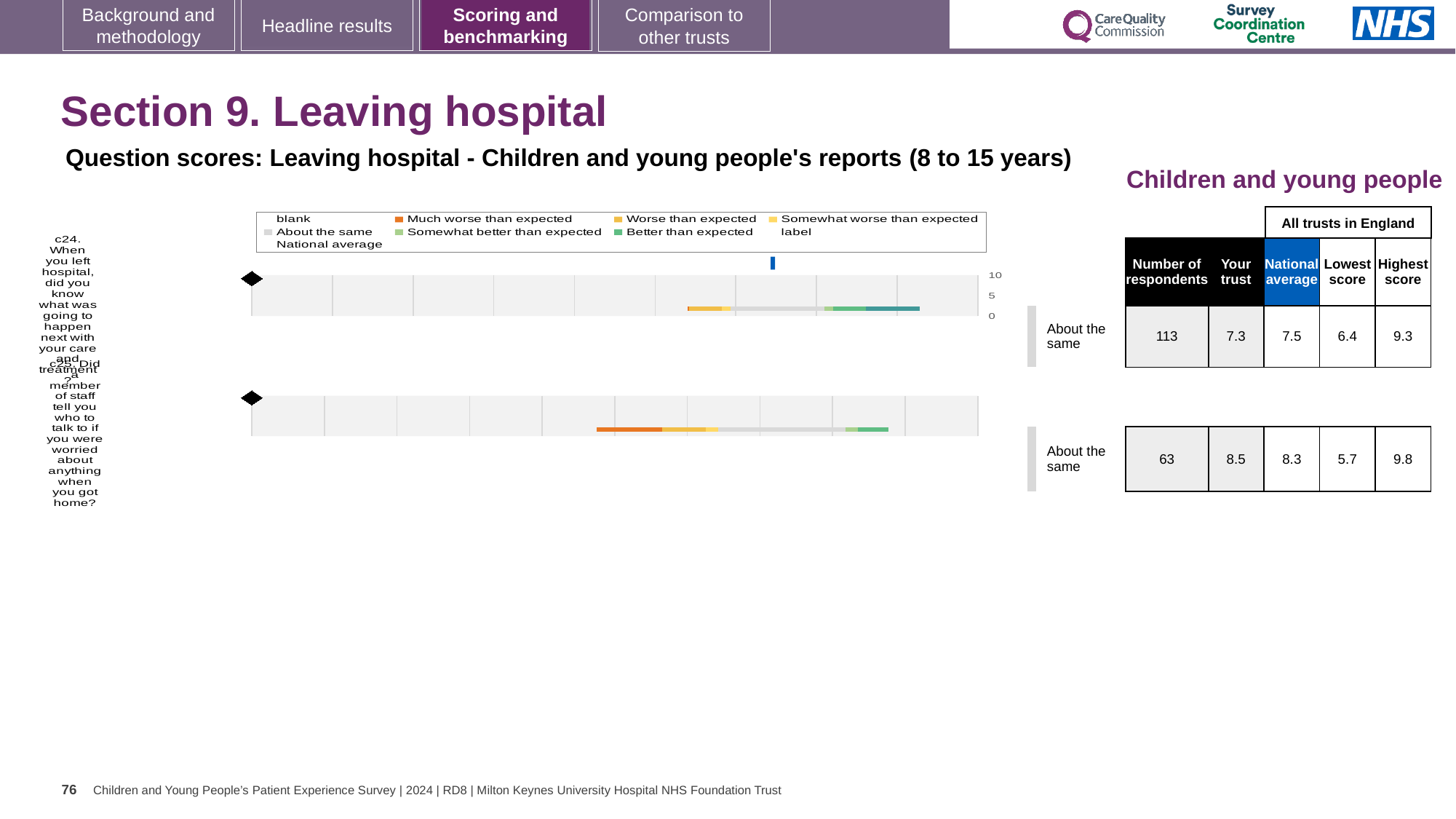
What kind of chart is used to show the question scores for c24 and c25? Bar chart What is the lowest score among all trusts in England for question c25? 5.7 How many questions (bars) are plotted on the slide? 2 How many more respondents answered c24 than c25? 50 What colour does the legend use for 'Much worse than expected'? Orange For question c24, what is the difference between the highest score (9.3) and the lowest score (6.4) across all trusts? 2.9 How many respondents answered question c24? 113 Which benchmark category is shown for question c25? About the same For question c24, which is larger: the 'Your trust' score or the national average? National average For question c25 (did a member of staff tell you who to talk to if you were worried), what is the national average score? 8.3 For question c25, which is larger: the 'Your trust' score or the national average? Your trust For question c24 (did you know what was going to happen next with your care and treatment), what is the 'Your trust' score? 7.3